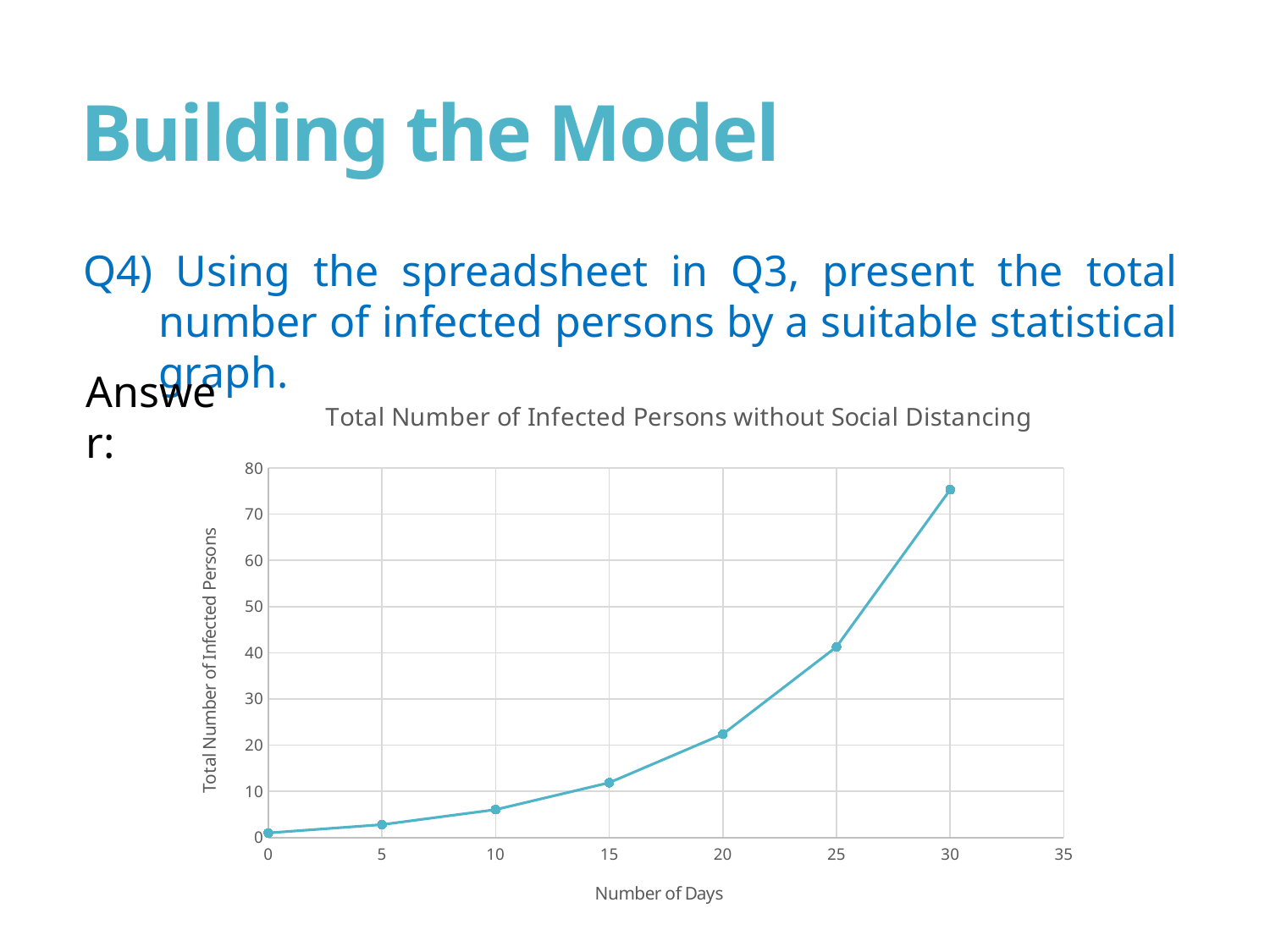
What kind of chart is shown on the slide? line chart Is the value at 20 days greater or less than 20? greater Which is larger, the value at 25 days or the value at 20 days? 25 days What is the title of the chart? Total Number of Infected Persons without Social Distancing How many data points are plotted on the line? 7 Do the values rise or fall as the number of days increases? rise At which number of days is the total number of infected persons highest? 30 Is the value at 30 days greater or less than 70? greater Is the value at 15 days greater or less than 20? less At which number of days is the total number of infected persons lowest? 0 What is the label of the x axis of the chart? Number of Days